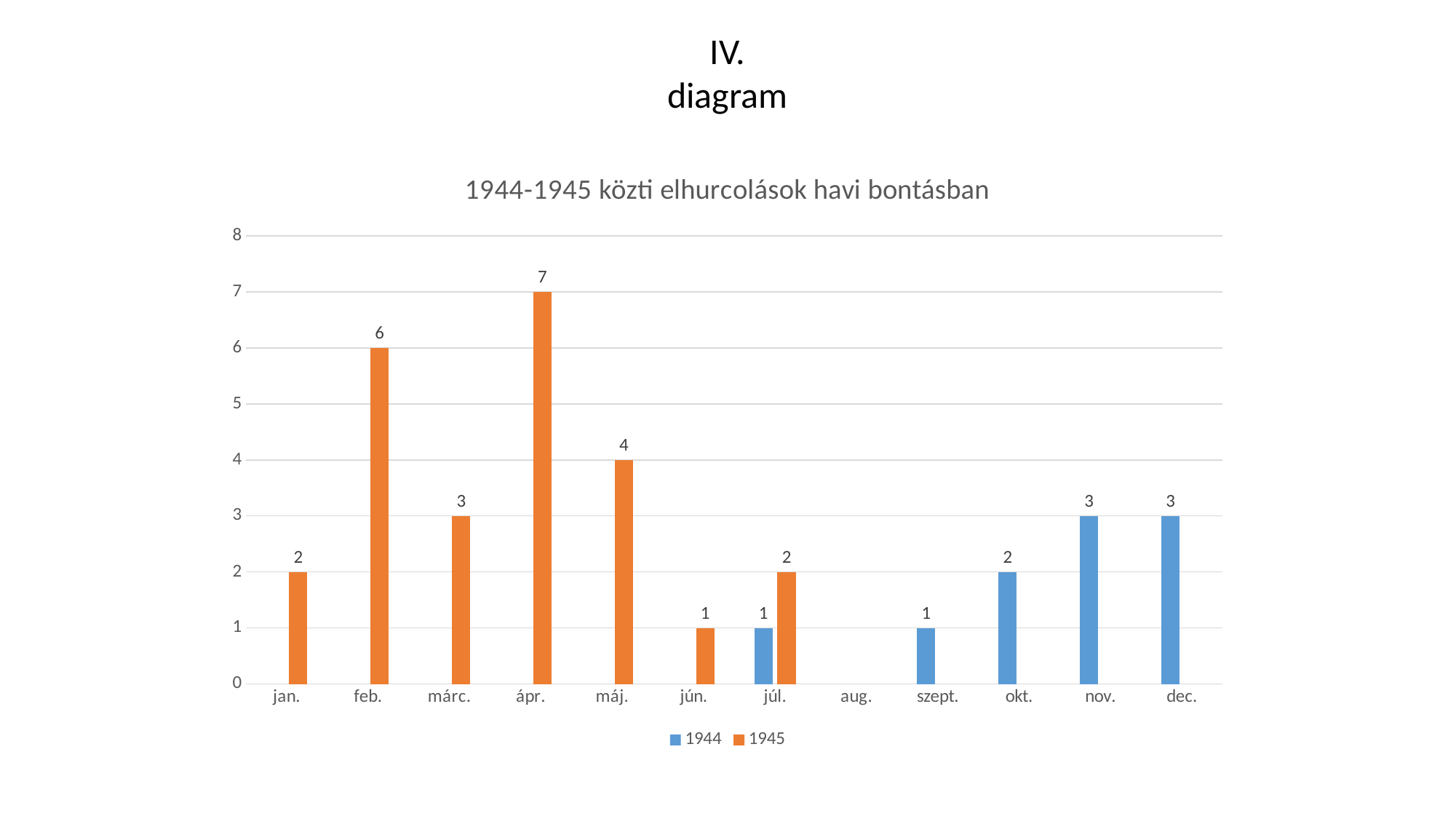
What is the difference between the 1945 values for ápr. and máj.? 3 What is the value for 1945 in feb.? 6 What is the value for 1944 in nov.? 3 How many months are shown on the x axis? 12 What is the title of the chart? 1944-1945 közti elhurcolások havi bontásban What kind of chart is shown on the slide? bar chart What is the value for 1945 in ápr.? 7 Which month has the lowest value for the 1944 series? szept. and júl. What is the value for 1944 in júl.? 1 How many series does the legend list? 2 Which month has the highest value for the 1945 series? ápr. Which is larger: the 1945 value for feb. or the 1945 value for márc.? feb.